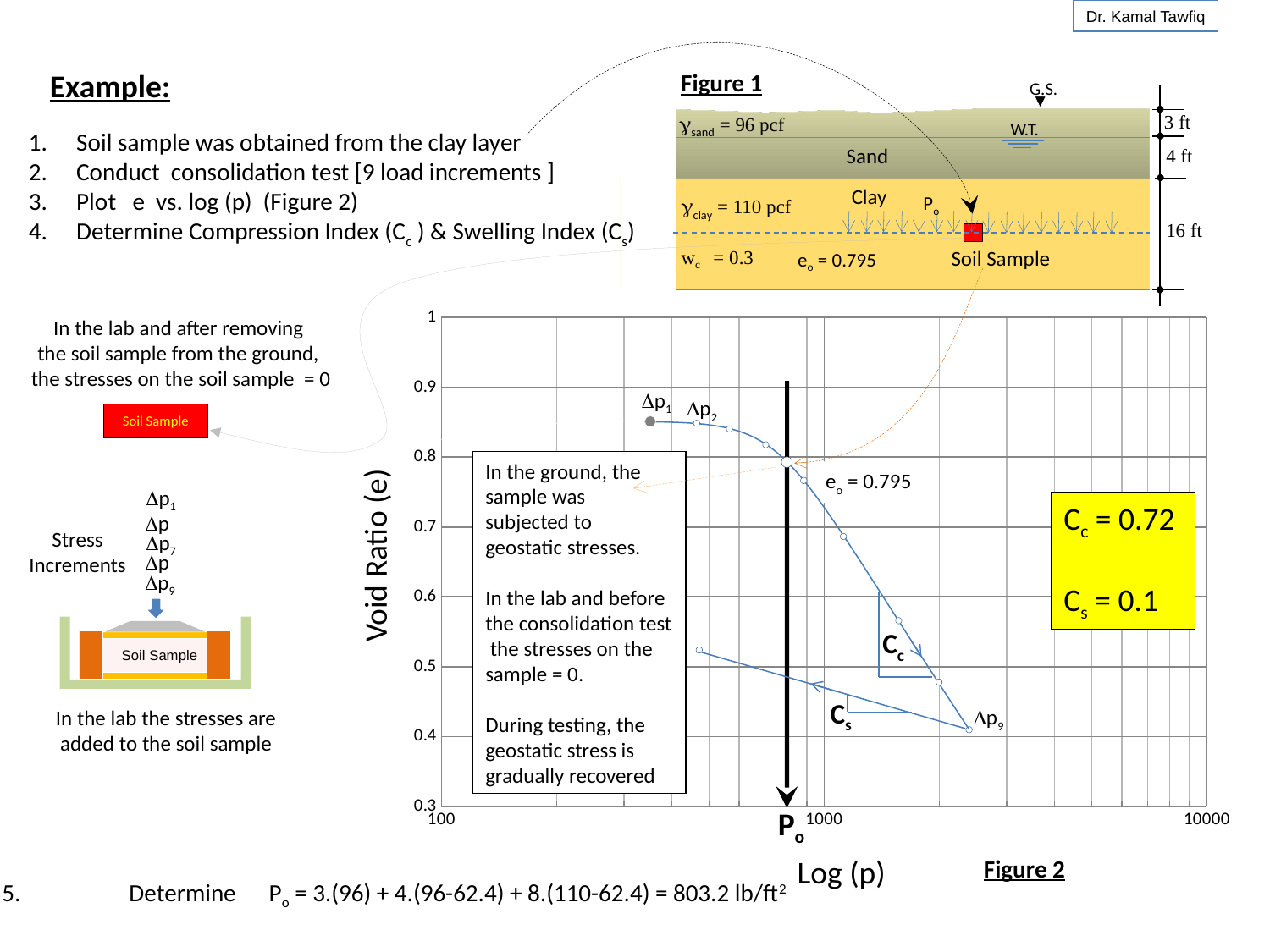
What kind of chart is Figure 2? line chart In Figure 2, what is the value of the initial void ratio e_o marked on the curve? 0.795 What is the value of P_o computed on the slide for the soil sample? 803.2 lb/ft² What is the label of the vertical axis in Figure 2? Void Ratio (e) In Figure 2, is the void ratio at the first load increment Δp1 greater or less than 0.8? greater How many load increments were applied in the consolidation test plotted in Figure 2? 9 In Figure 2, what is the Swelling Index C_s given on the slide? 0.1 In Figure 2, which has the larger void ratio, the point at Δp1 or the point at Δp9? Δp1 In Figure 2, what is the Compression Index C_c given on the slide? 0.72 In Figure 2, does the void ratio rise or fall along the loading curve as p increases? fall In Figure 2, is the void ratio at load increment Δp9 greater or less than 0.5? less In Figure 2, what is the difference between C_c and C_s? 0.62